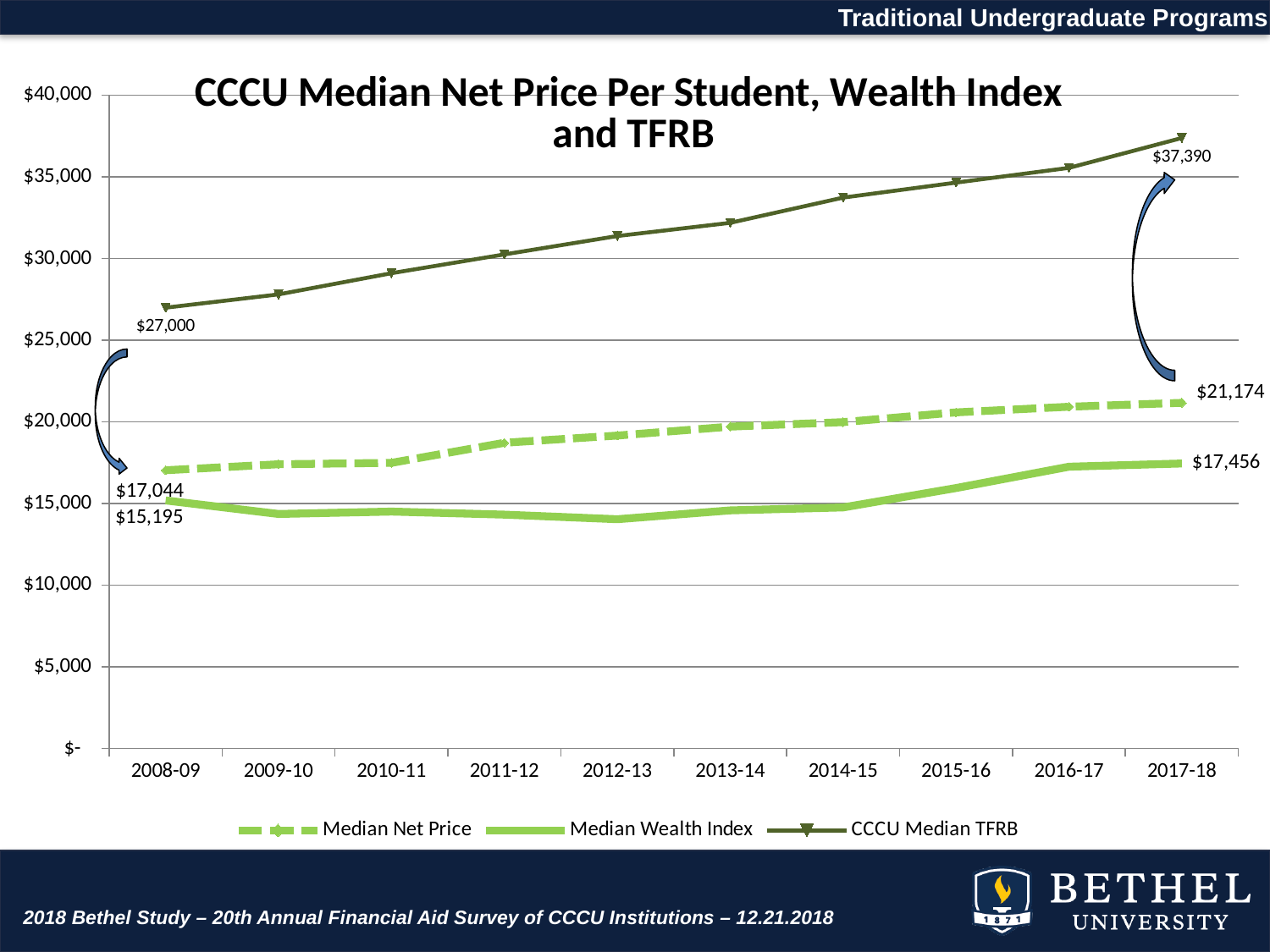
What is the CCCU Median TFRB value for 2008-09? $27,000 How many series does the legend list? 3 How many academic years are shown on the x axis? 10 What is the Median Net Price for 2017-18? $21,174 What is the difference between the Median Net Price and the Median Wealth Index in 2017-18? $3,718 Is the Median Wealth Index for 2012-13 greater or less than $15,000? less By how much did the CCCU Median TFRB increase from 2008-09 to 2017-18? $10,390 What is the title of the chart? CCCU Median Net Price Per Student, Wealth Index and TFRB What is the CCCU Median TFRB value for 2017-18? $37,390 What is the Median Wealth Index for 2008-09? $15,195 Which series has the highest values across all years? CCCU Median TFRB What kind of chart is shown on the slide? line chart